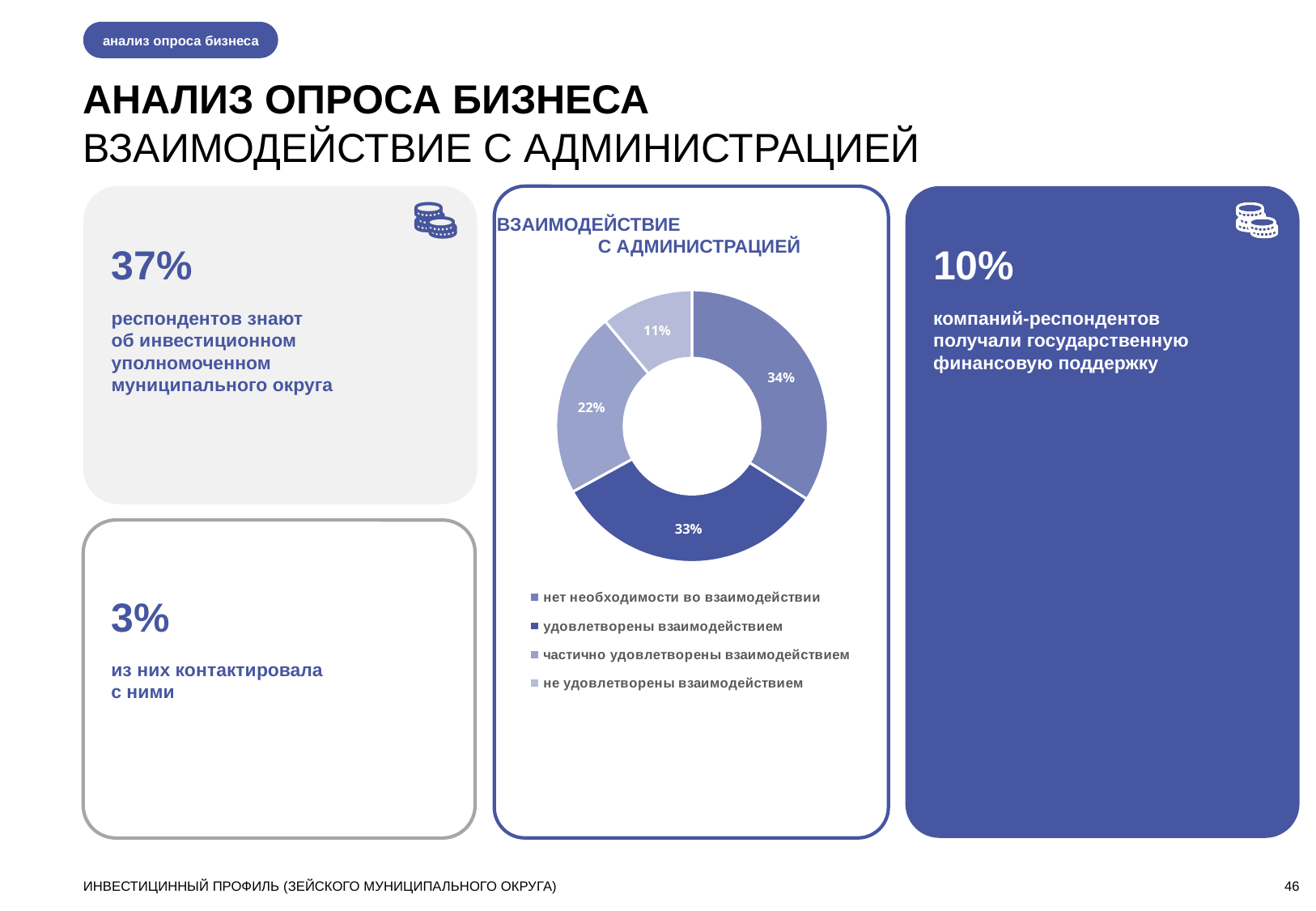
What share of respondents answered 'не удовлетворены взаимодействием'? 11% What is the title of the chart? ВЗАИМОДЕЙСТВИЕ С АДМИНИСТРАЦИЕЙ What share of respondents answered 'нет необходимости во взаимодействии'? 34% What kind of chart is shown on the slide? Donut (pie) chart Which is larger: the share for 'удовлетворены взаимодействием' or for 'частично удовлетворены взаимодействием'? удовлетворены взаимодействием Which category has the largest share in the chart? нет необходимости во взаимодействии Which category has the smallest share in the chart? не удовлетворены взаимодействием What share of respondents answered 'удовлетворены взаимодействием'? 33% What is the difference in percentage points between 'частично удовлетворены взаимодействием' and 'не удовлетворены взаимодействием'? 11 How many slices does the donut chart have? 4 Which legend entry is shown in the darkest blue colour? удовлетворены взаимодействием What share of respondents answered 'частично удовлетворены взаимодействием'? 22%